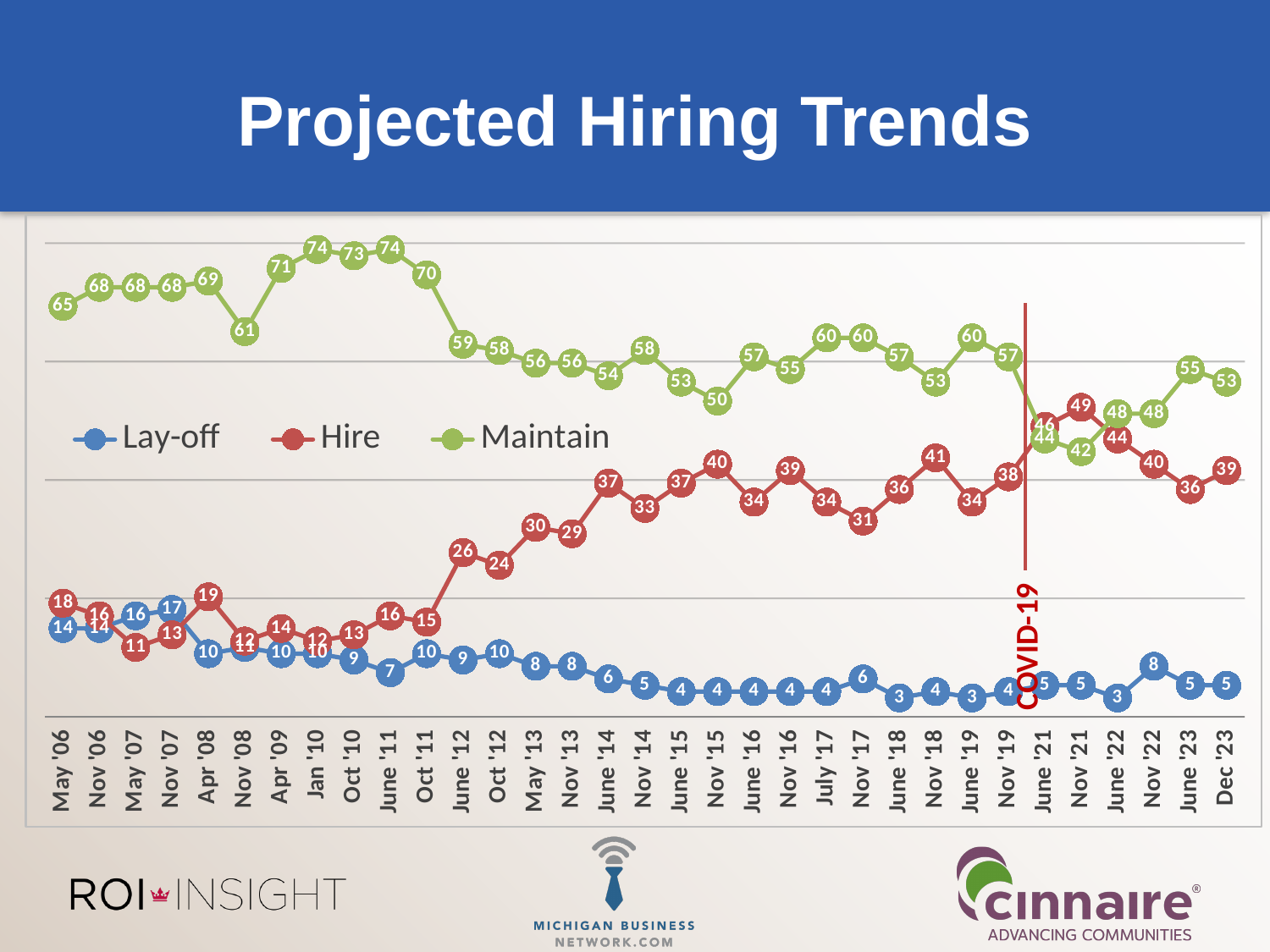
How many series does the legend list? 3 What label is written on the vertical red line drawn on the chart? COVID-19 At which date does the Lay-off series reach its highest value? Nov '07 What is the Hire value for Nov '21? 49 What is the difference between the Hire value and the Lay-off value for Dec '23? 34 At which date does the Hire series reach its highest value? Nov '21 What is the Maintain value for Dec '23? 53 Does the Lay-off series generally rise or fall from May '06 to Dec '23? fall What is the Lay-off value for Nov '22? 8 At which date does the Maintain series reach its lowest value? Nov '21 For Nov '21, which is larger: the Hire value or the Maintain value? Hire What kind of chart is shown on the slide? line chart